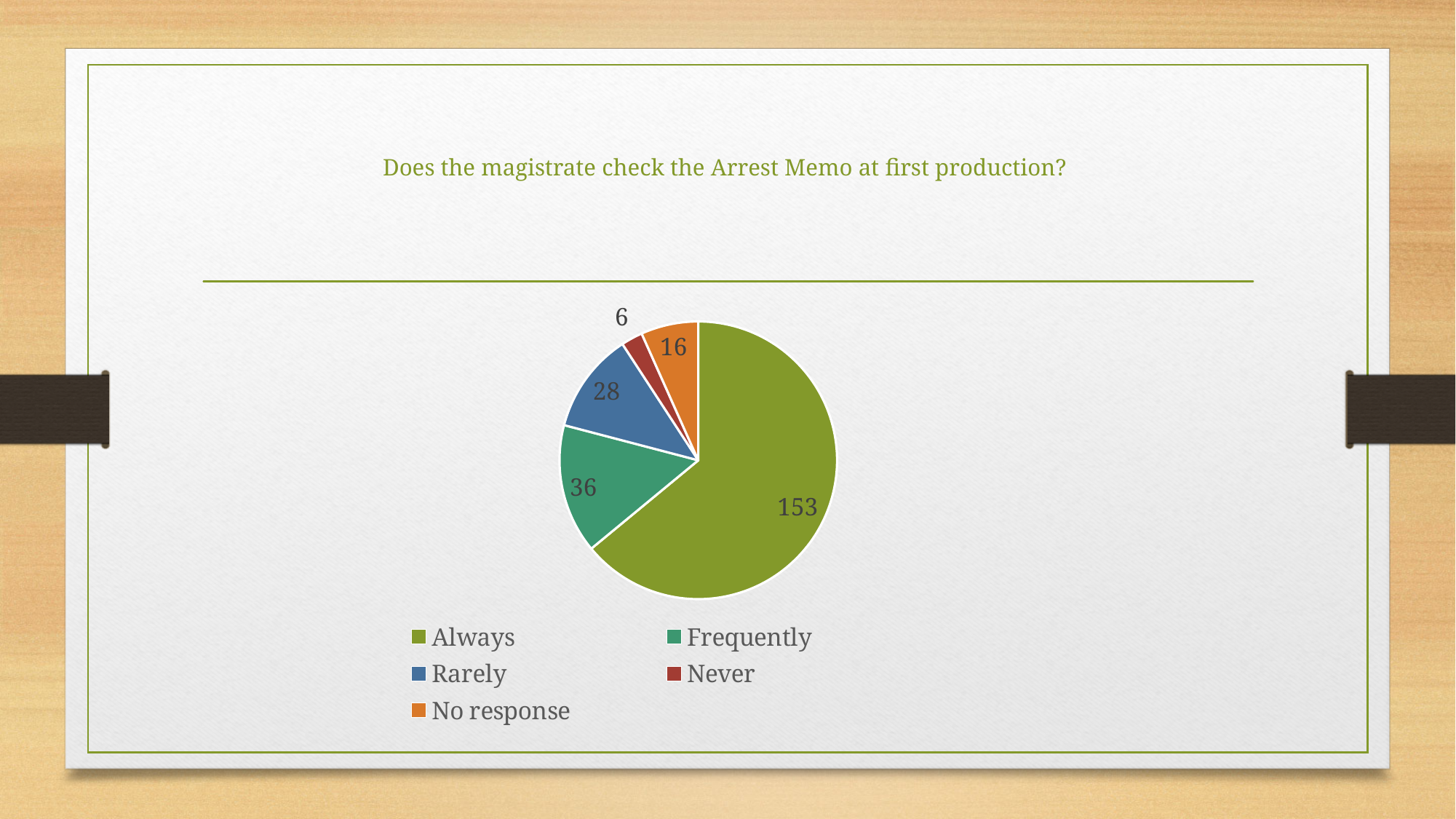
What is the title of the chart? Does the magistrate check the Arrest Memo at first production? What is the value for Rarely? 28 What is the value for Frequently? 36 What kind of chart is shown on the slide? pie chart Which category has the smallest slice? Never How many categories does the pie chart have? 5 Which is larger, Rarely or No response? Rarely What is the value for Never? 6 Which category has the largest slice? Always What is the value for Always? 153 What is the value for No response? 16 What is the difference between the values for Always and Frequently? 117